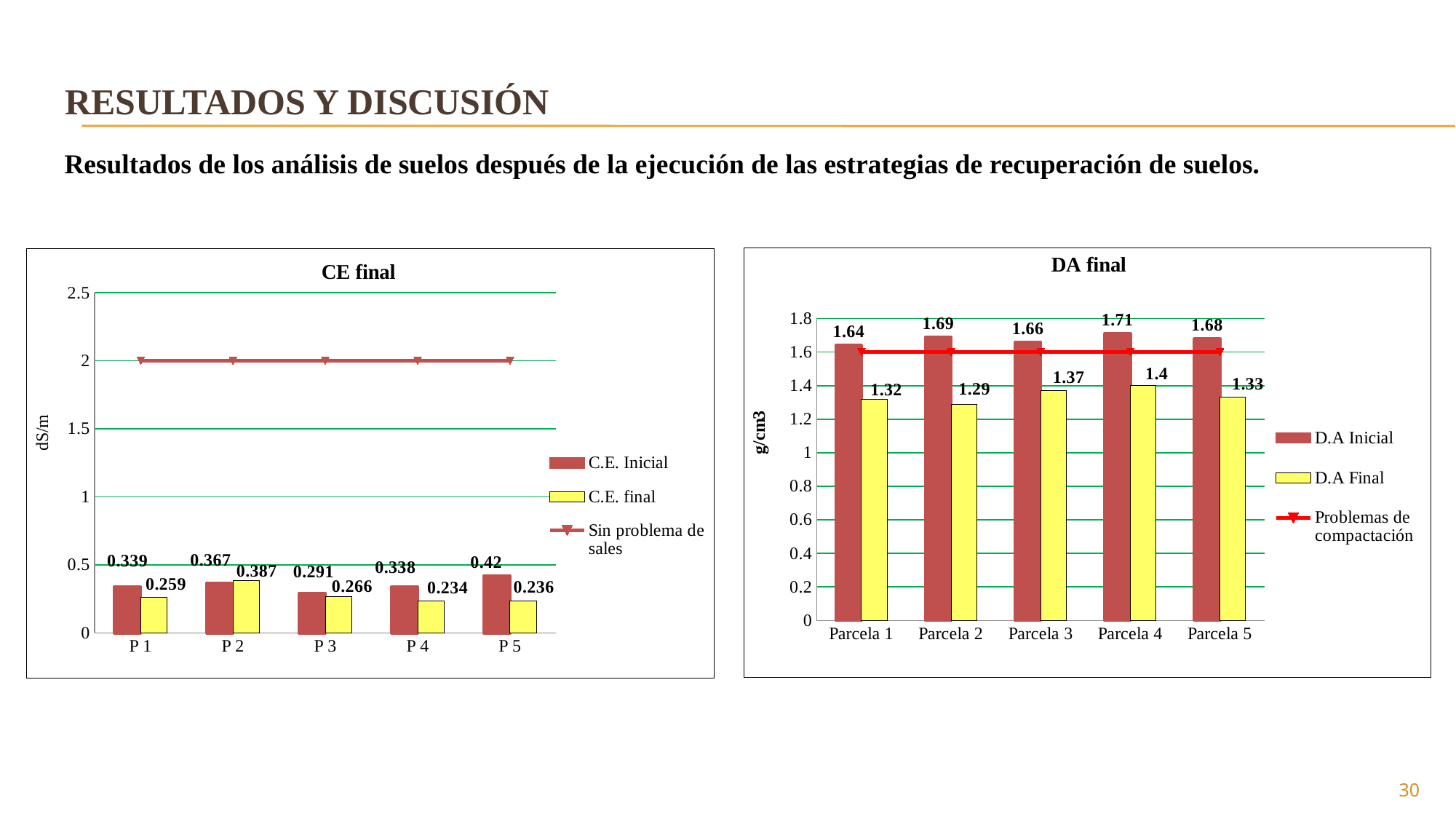
In the 'CE final' chart, what is the C.E. Inicial value for P 5? 0.42 In the 'DA final' chart, what is the difference between D.A Inicial and D.A Final for Parcela 3? 0.29 In the 'CE final' chart, at what value does the 'Sin problema de sales' line sit? 2 In the 'CE final' chart, what is the C.E. final value for P 2? 0.387 In the 'DA final' chart, what is the D.A Final value for Parcela 4? 1.4 In the 'DA final' chart, which parcela has the lowest D.A Final value? Parcela 2 In the 'DA final' chart, which parcela has the highest D.A Inicial value? Parcela 4 What kind of chart is the 'DA final' chart? Bar chart with a line In the 'CE final' chart, how many series does the legend list? 3 In the 'CE final' chart, which category has the lowest C.E. Inicial value? P 3 In the 'DA final' chart, how many parcelas are shown on the x axis? 5 In the 'CE final' chart, what is the difference between the C.E. Inicial and C.E. final values for P 1? 0.08